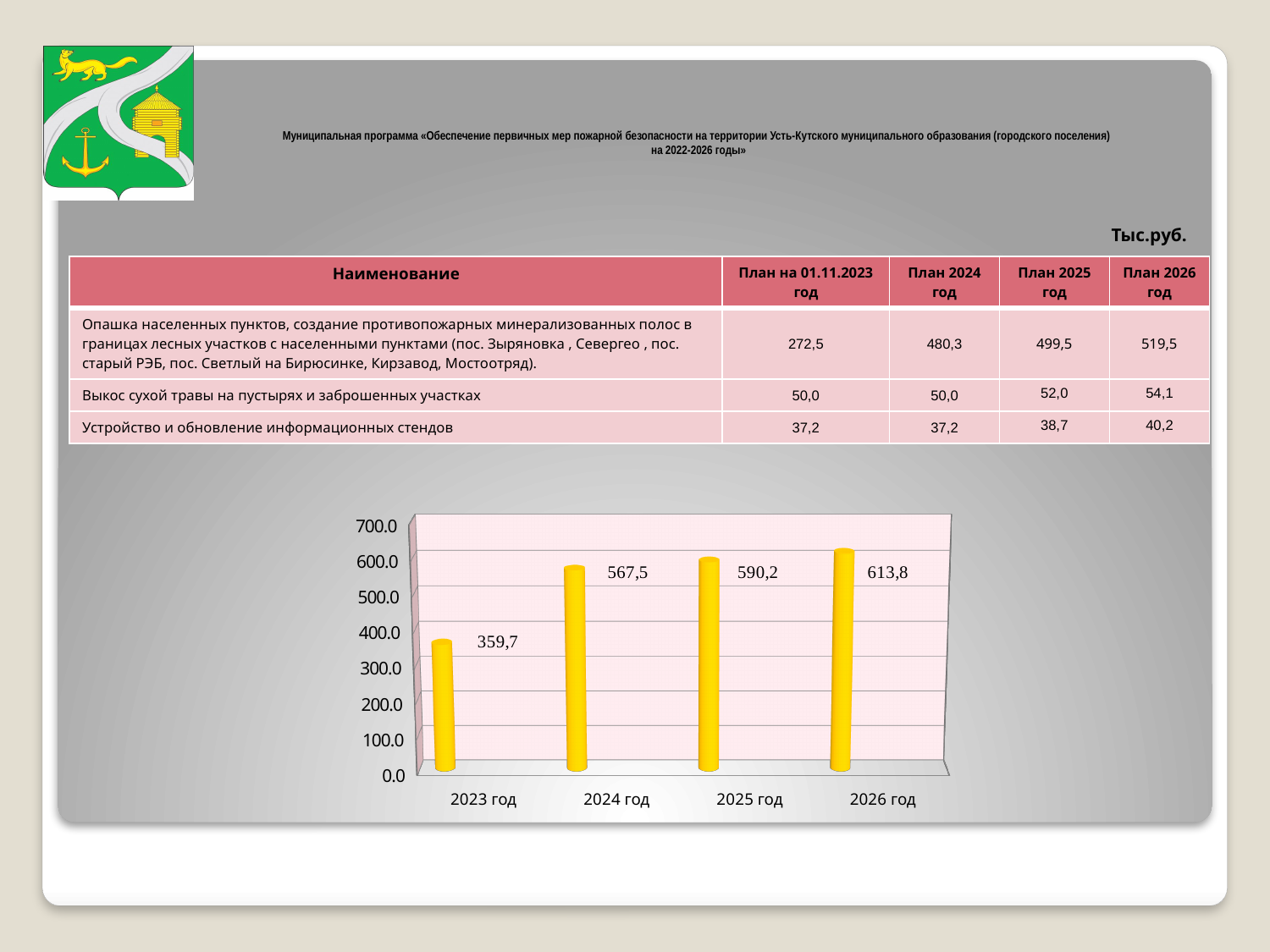
What is the value for 2024 год in the chart? 567,5 How many bars are shown in the chart? 4 What is the value for 2025 год in the chart? 590,2 Do the values rise or fall from 2023 год to 2026 год? rise Is the value for 2023 год greater or less than 400.0? less What is the difference between the values for 2026 год and 2023 год? 254,1 Which is larger, the value for 2024 год or the value for 2025 год? 2025 год What is the value for 2023 год in the chart? 359,7 Which year has the highest value in the chart? 2026 год What is the value for 2026 год in the chart? 613,8 Which year has the lowest value in the chart? 2023 год What is the difference between the values for 2025 год and 2024 год? 22,7